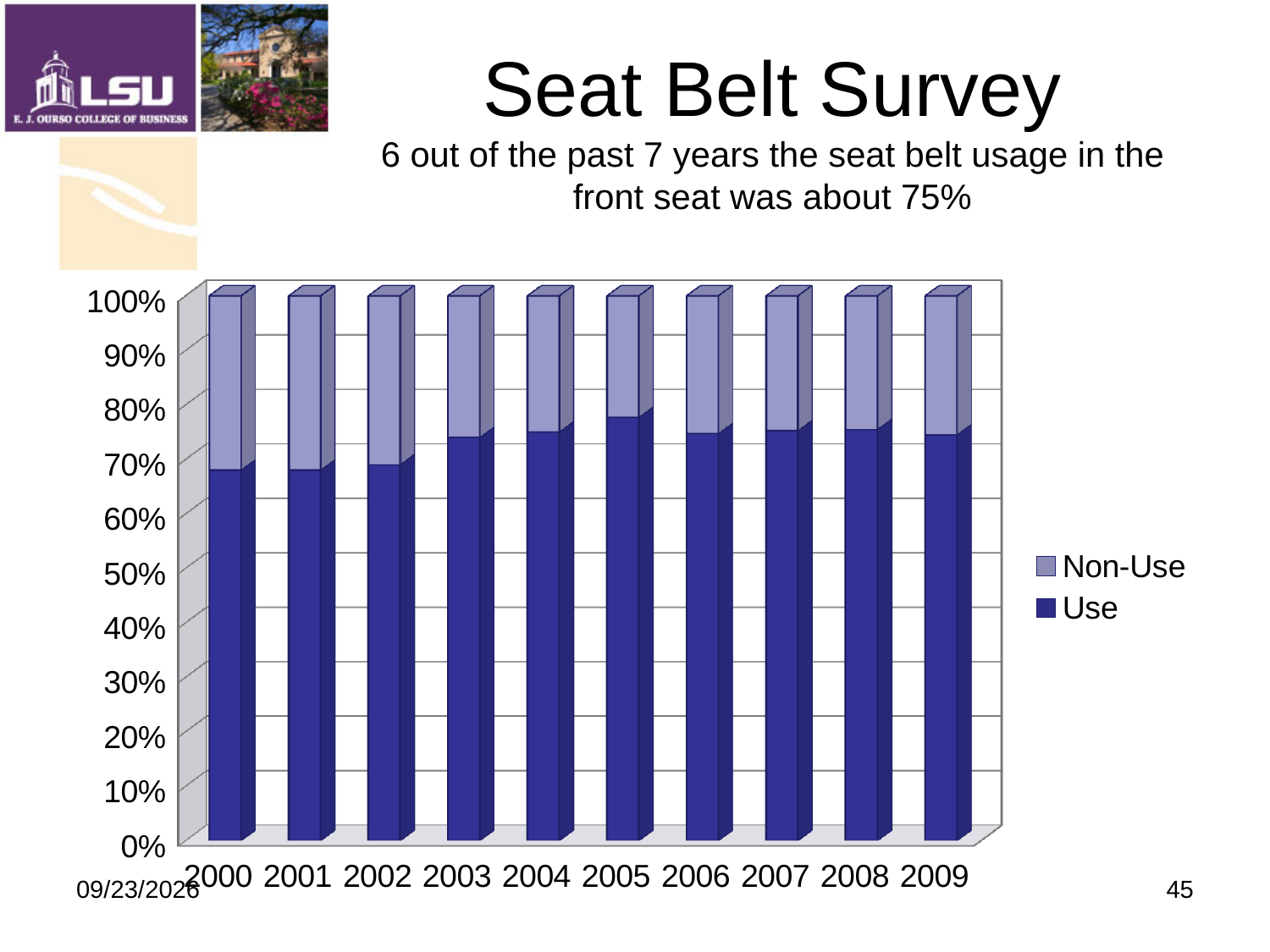
Is the Use value for 2005 greater or less than 70%? greater Which year has the larger Use share, 2000 or 2005? 2005 What are the two series named in the chart legend? Non-Use and Use What kind of chart is shown on the slide? Stacked bar chart In which year is the Use share the highest? 2005 Does the Use share rise or fall from 2000 to 2005? rise Is the Use value for 2003 greater or less than 80%? less Is the Use value for 2000 greater or less than 70%? less How many series does the chart legend list? 2 What is the total height of each stacked bar (Use plus Non-Use)? 100% What is the title of the slide containing the chart? Seat Belt Survey How many years are shown along the x axis of the chart? 10